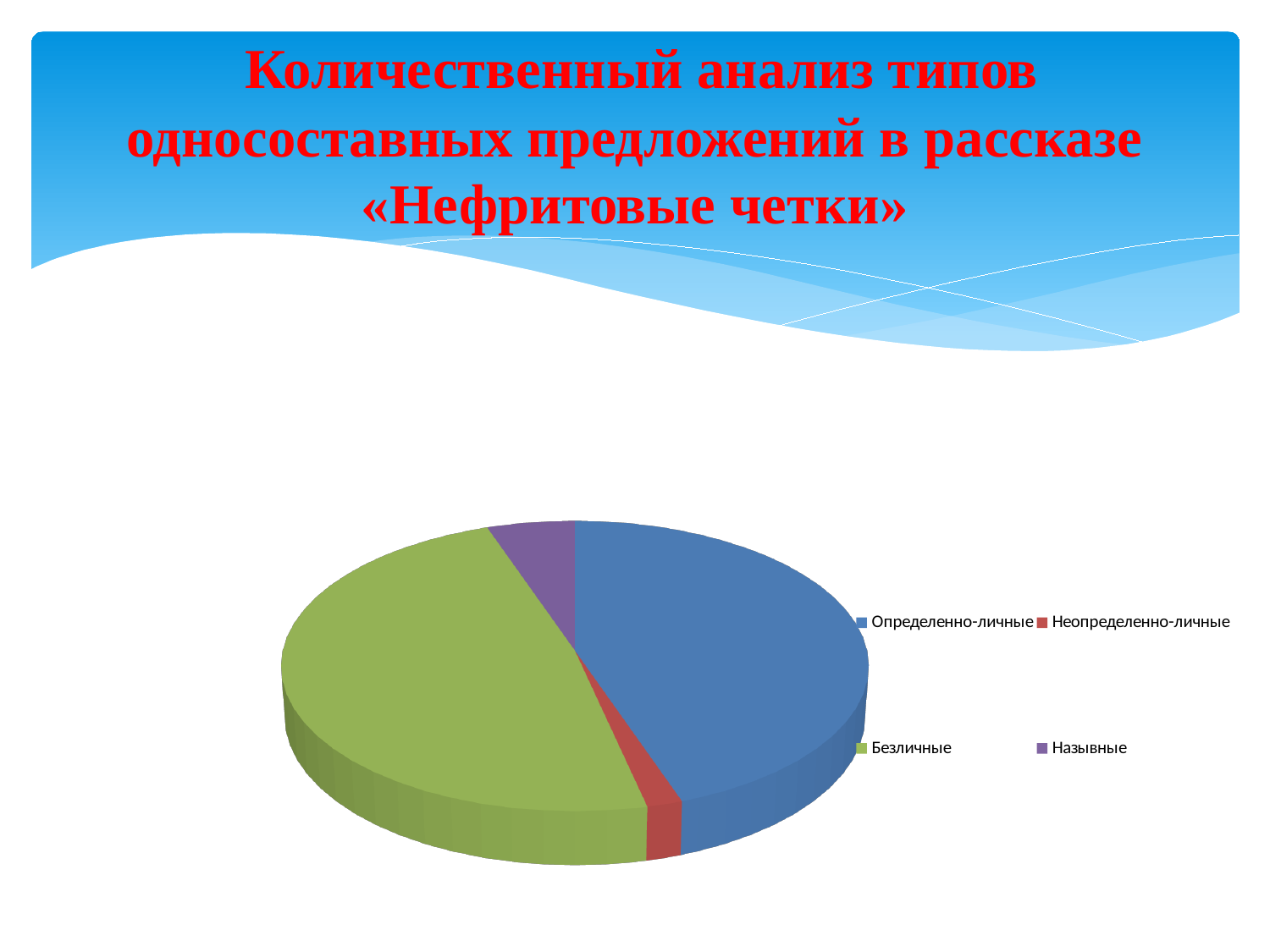
What kind of chart is shown on the slide? pie chart Which slice is larger: Назывные or Неопределенно-личные? Назывные Which slice is larger: Безличные or Назывные? Безличные What colour is the Безличные slice in the pie chart? green Which category has the smallest slice in the pie chart? Неопределенно-личные Which slice is larger: Определенно-личные or Неопределенно-личные? Определенно-личные Which category is shown in blue in the pie chart? Определенно-личные How many categories (slices) does the pie chart have? 4 How many entries does the legend of the pie chart list? 4